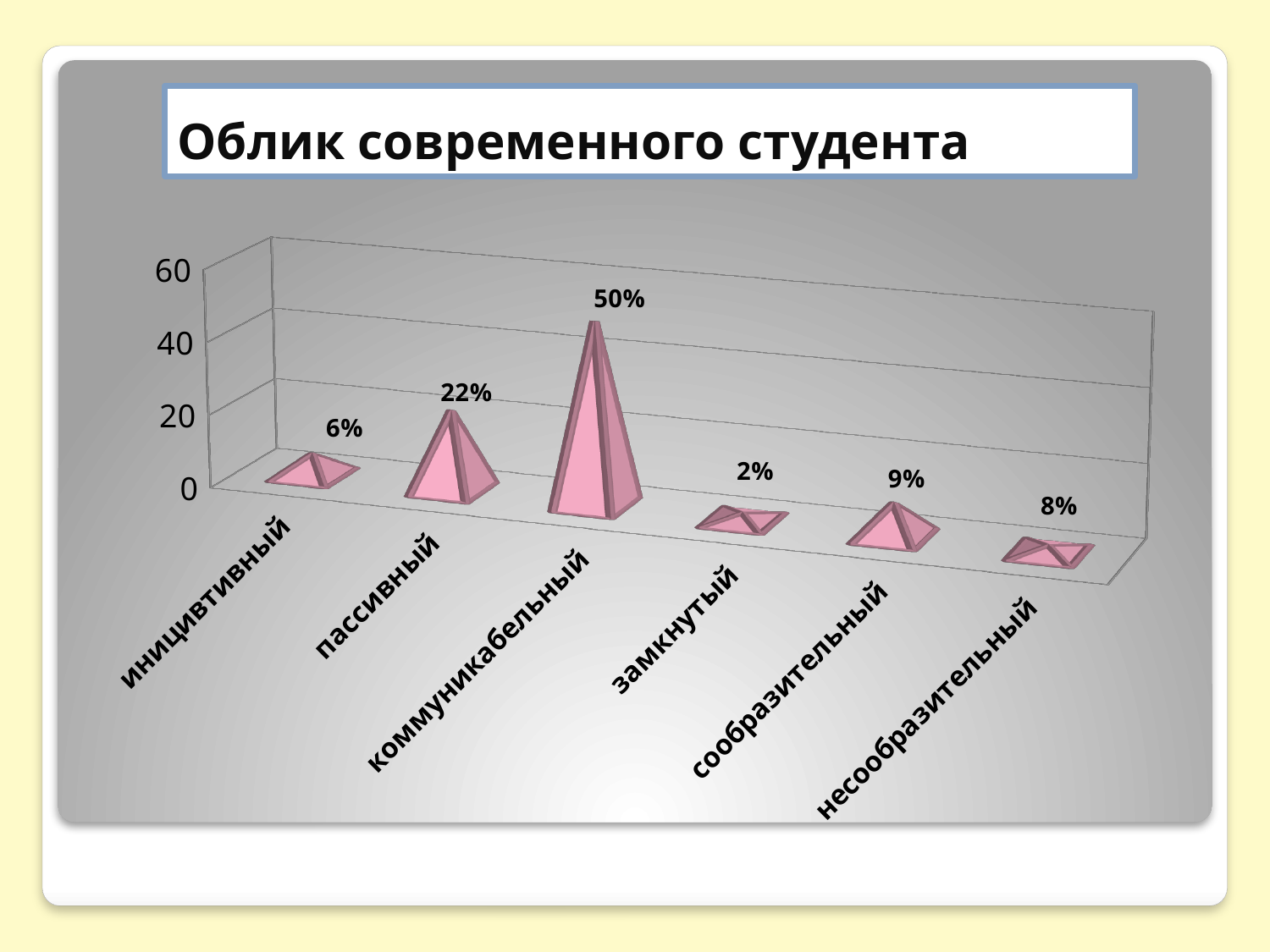
How many categories are shown on the chart? 6 What is the title of the chart? Облик современного студента What is the value for пассивный? 22% Which is larger, the value for сообразительный or the value for инициативный? сообразительный Is the value for пассивный greater or less than 20? greater Which category has the lowest value? замкнутый What is the value for коммуникабельный? 50% Which category has the highest value? коммуникабельный What is the value for несообразительный? 8% What is the value for замкнутый? 2% What is the difference between the values for коммуникабельный and пассивный? 28% What kind of chart is shown on the slide? bar chart